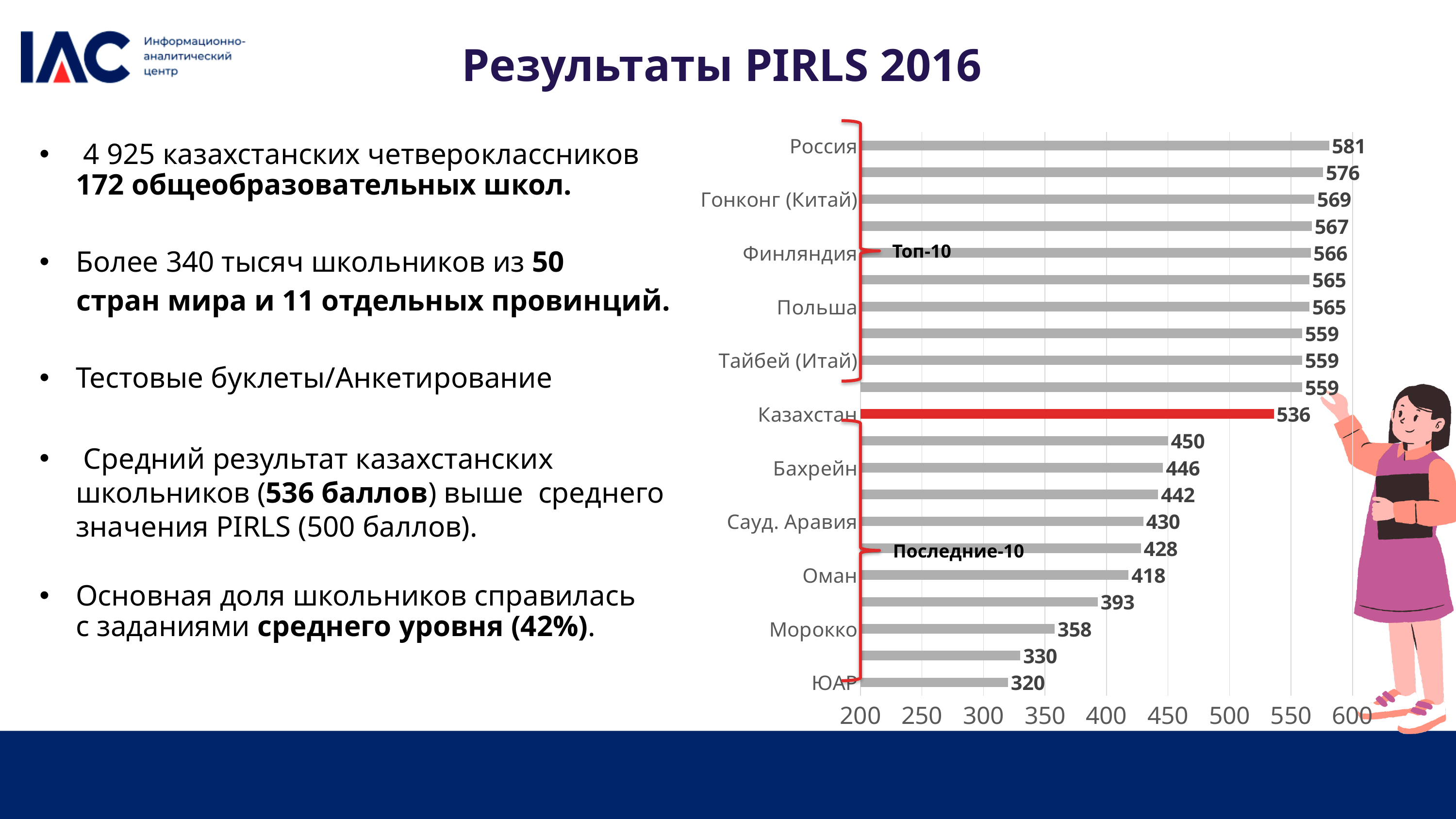
What kind of chart is shown on the slide? bar chart What value is shown for Сауд. Аравия? 430 Which labelled country has the lowest value? ЮАР Which labelled country has the highest value? Россия What value is shown for ЮАР? 320 What colour is the bar for Казахстан? red Which has a larger value, Бахрейн or Оман? Бахрейн What value is shown for Казахстан? 536 What is the difference between the values for Россия and Казахстан? 45 Is the value for Морокко greater or less than 400? less What value is shown for Финляндия? 566 What value is shown for Россия? 581